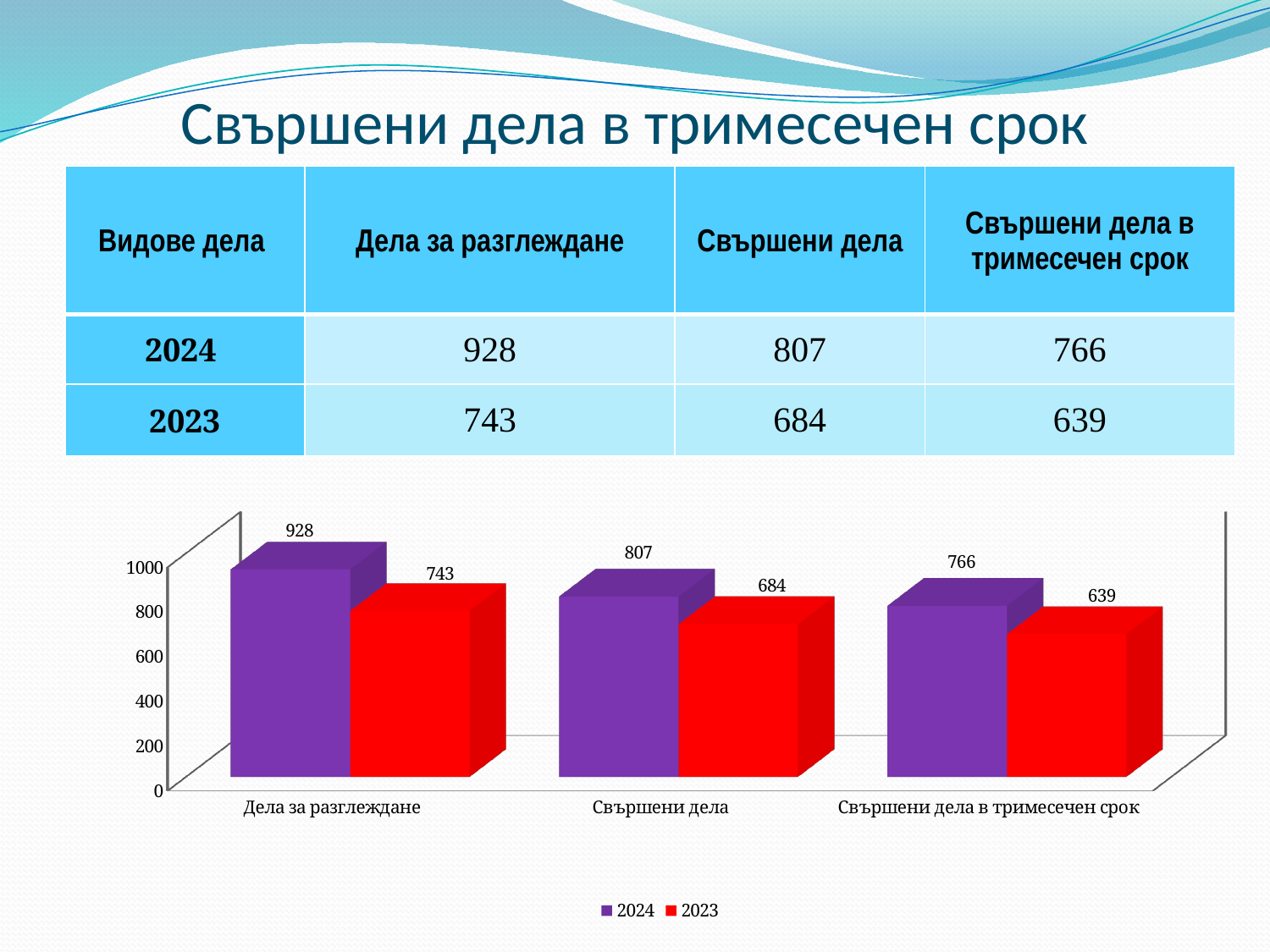
Is the 2023 value for "Дела за разглеждане" greater or less than 800? less Which category has the highest value for the 2024 series? Дела за разглеждане What is the difference between the 2024 and 2023 values in the "Свършени дела в тримесечен срок" category? 127 What is the value for 2024 in the "Дела за разглеждане" category? 928 What kind of chart is shown on the slide? bar chart What is the difference between the 2024 and 2023 values in the "Дела за разглеждане" category? 185 Which category has the lowest value for the 2023 series? Свършени дела в тримесечен срок How many series does the chart legend list? 2 What is the value for 2023 in the "Свършени дела в тримесечен срок" category? 639 How many categories are shown on the x axis of the chart? 3 What is the value for 2023 in the "Свършени дела" category? 684 Which is larger in the "Свършени дела" category: the 2024 value or the 2023 value? 2024